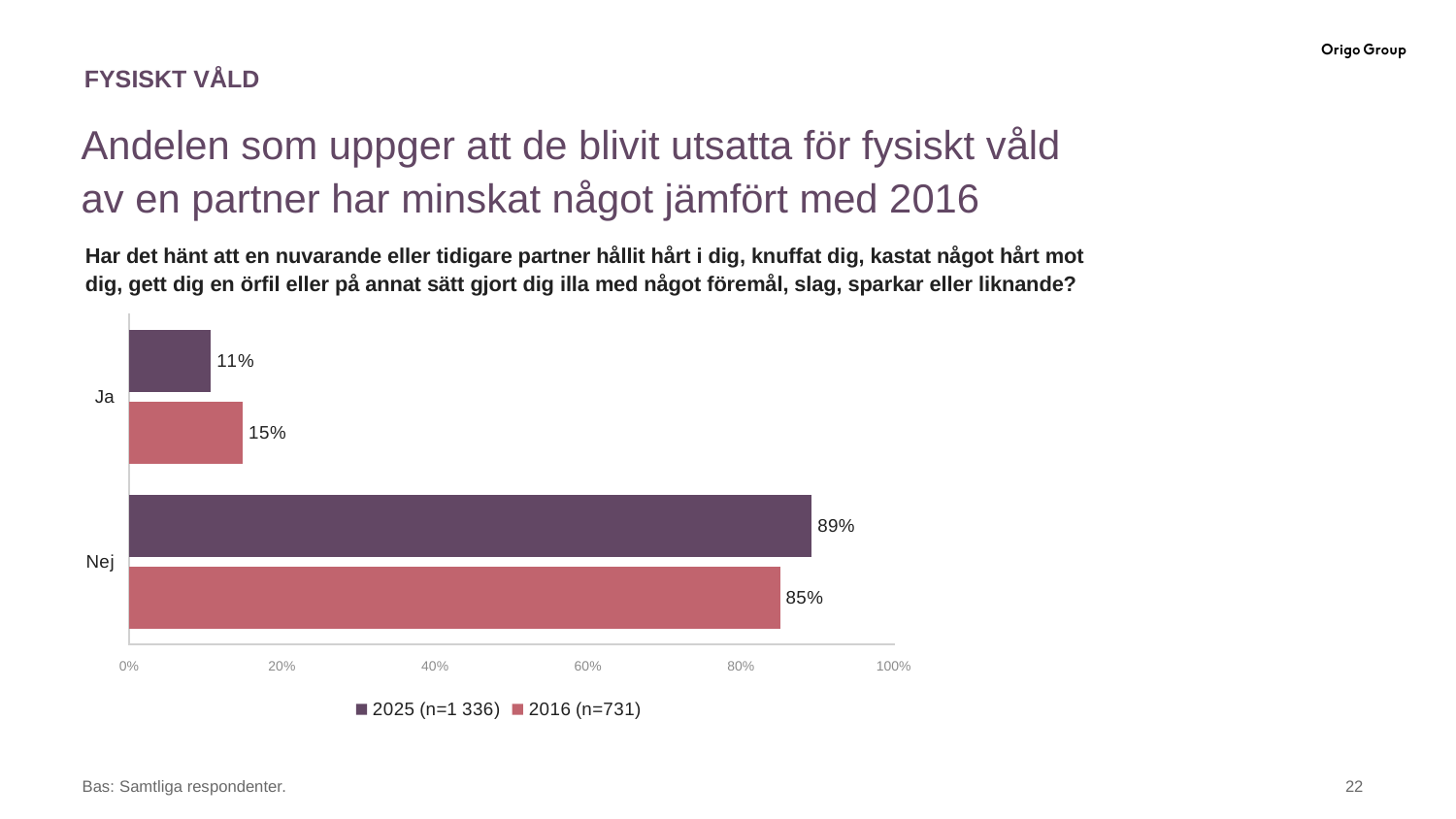
What is the value for "Ja" in the 2016 (n=731) series? 15% What is the value for "Nej" in the 2016 (n=731) series? 85% What is the difference between the 2016 and 2025 values for "Ja"? 4 percentage points Which category has the lowest value in the 2016 (n=731) series? Ja What is the value for "Nej" in the 2025 (n=1 336) series? 89% Which is larger for "Nej": the 2025 value or the 2016 value? 2025 How many categories are shown on the chart? 2 How many series does the legend list? 2 Which category has the highest value in the 2025 (n=1 336) series? Nej What is the value for "Ja" in the 2025 (n=1 336) series? 11% What kind of chart is shown on the slide? Bar chart Is the 2025 value for "Nej" greater or less than 80%? greater